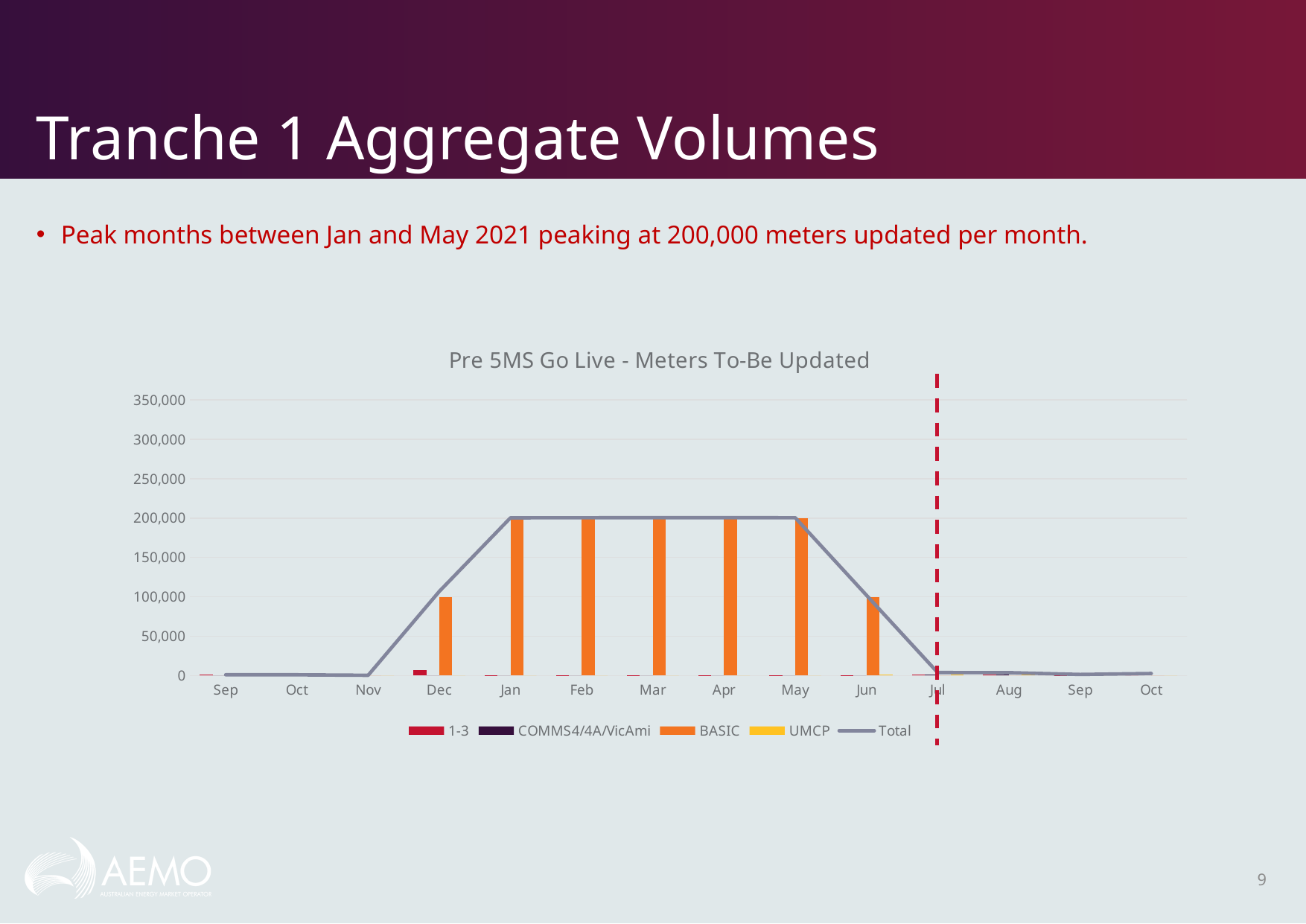
How many series does the chart legend list? 5 What is the title of the chart? Pre 5MS Go Live - Meters To-Be Updated Does the Total line rise or fall from May to Jul? fall Is the BASIC value for Dec greater or less than 150,000? less Which month has the larger BASIC value, Mar or Jun? Mar How many months are shown along the x axis of the chart? 14 What kind of chart is shown on the slide? Combined bar and line chart